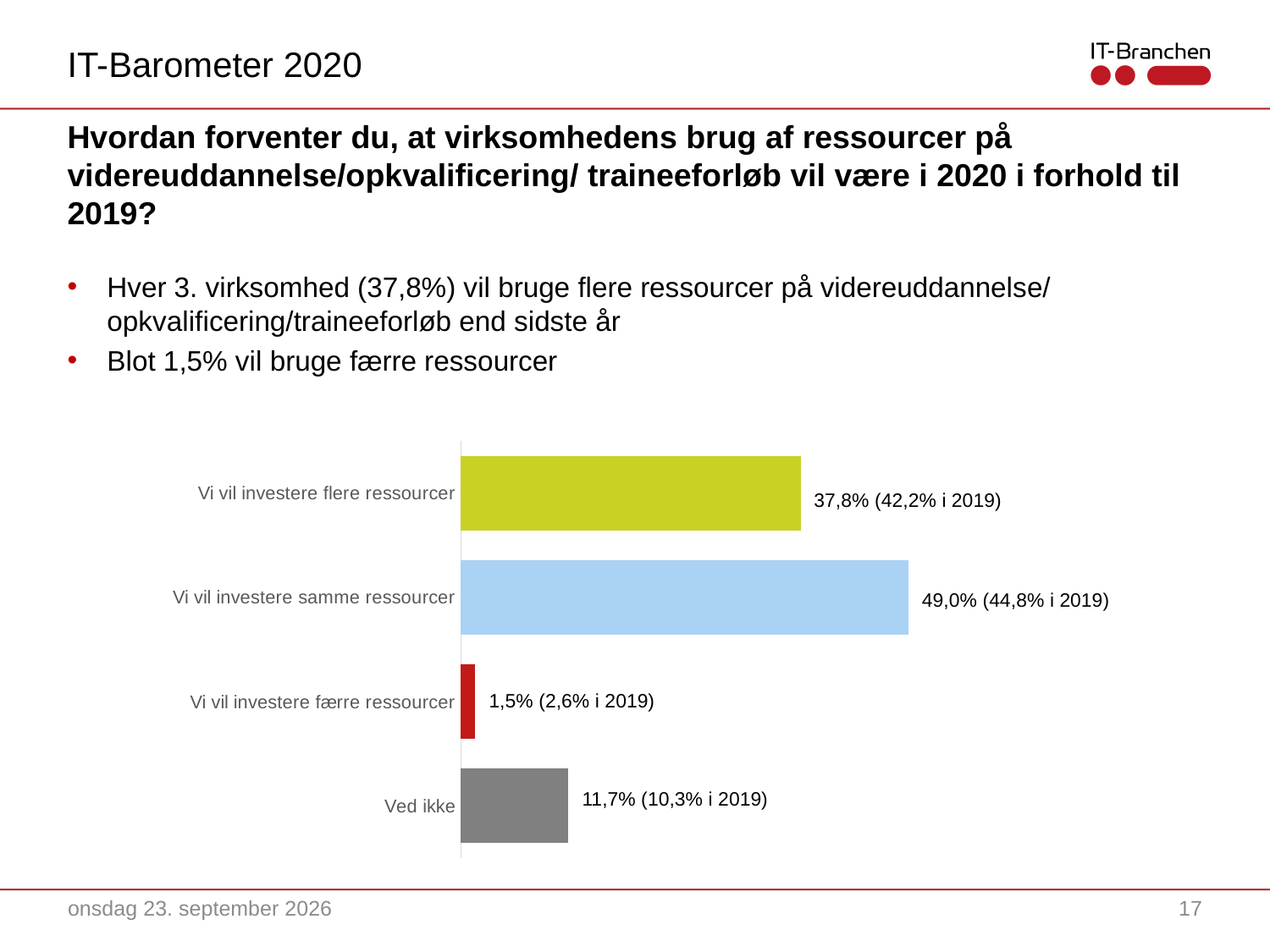
What is the 2020 value for "Ved ikke"? 11,7% What was the 2019 value for "Vi vil investere flere ressourcer"? 42,2% What colour is the bar for "Vi vil investere færre ressourcer"? Red Which is larger in 2020: "Ved ikke" or "Vi vil investere færre ressourcer"? Ved ikke What is the 2020 value for "Vi vil investere samme ressourcer"? 49,0% Which category has the lowest 2020 value? Vi vil investere færre ressourcer What is the difference between the 2020 values for "Vi vil investere samme ressourcer" and "Vi vil investere flere ressourcer"? 11,2% What kind of chart is shown on the slide? Bar chart How many categories does the chart show? 4 What is the 2020 value for "Vi vil investere flere ressourcer"? 37,8% Which category has the highest 2020 value? Vi vil investere samme ressourcer What was the 2019 value for "Vi vil investere færre ressourcer"? 2,6%